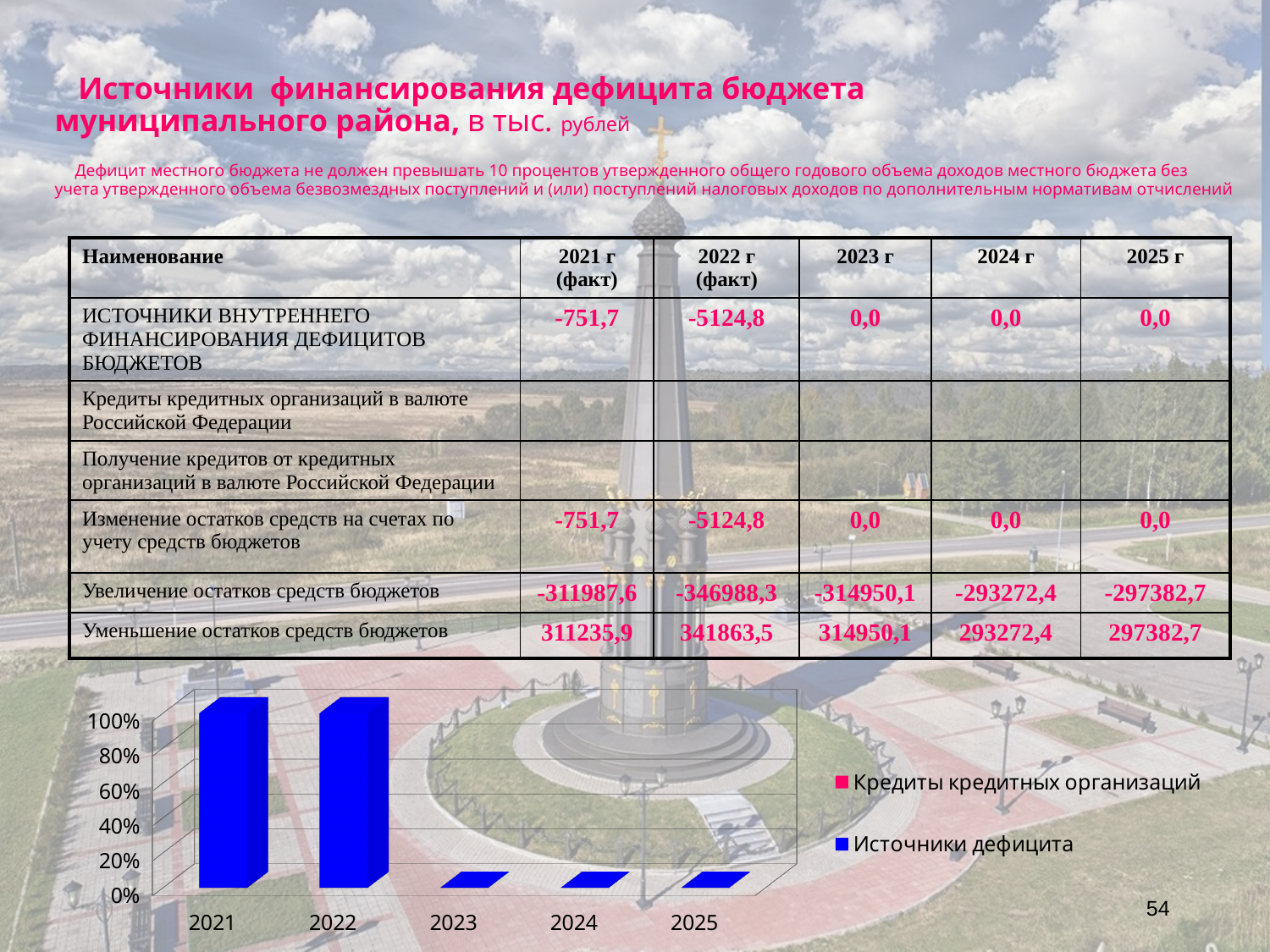
How many series does the legend of the bar chart list? 2 What are the two legend entries of the bar chart? Кредиты кредитных организаций; Источники дефицита In the bar chart, is the value for 2023 greater or less than 20%? less In the bar chart, is the value for 2025 greater or less than 40%? less What kind of chart is shown at the bottom of the slide? bar chart In the bar chart, which bar is taller, 2021 or 2024? 2021 How many years are shown on the x axis of the bar chart? 5 In the bar chart, do the bars rise or fall from 2022 to 2023? fall In the bar chart, is the value for 2022 greater or less than 60%? greater Which colour represents Источники дефицита in the bar chart? blue In the bar chart, which bar is taller, 2022 or 2025? 2022